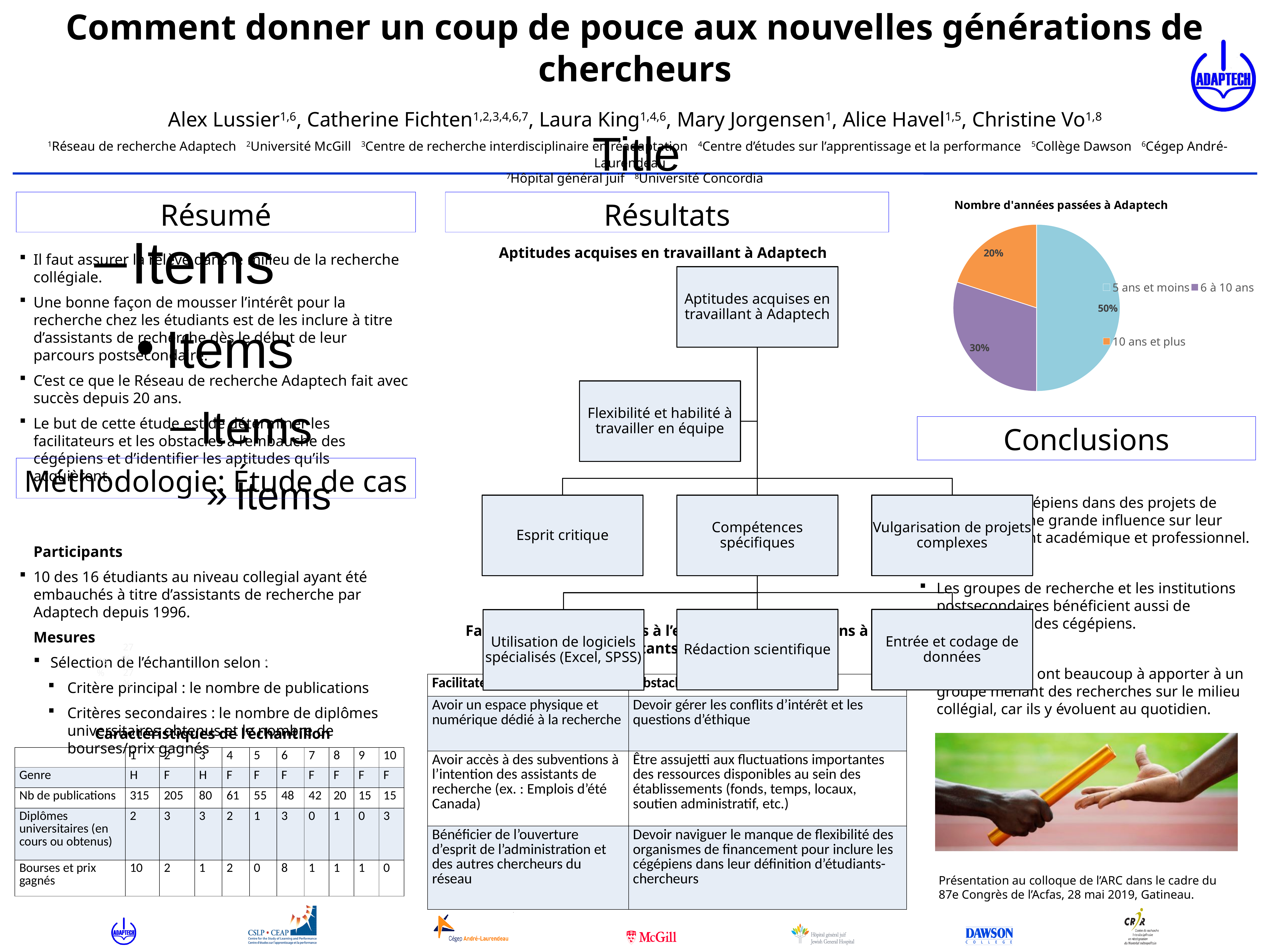
In the pie chart "Nombre d'années passées à Adaptech", which category has the smallest slice? 10 ans et plus How many slices does the pie chart "Nombre d'années passées à Adaptech" have? 3 In the pie chart "Nombre d'années passées à Adaptech", which category has the largest slice? 5 ans et moins In the pie chart "Nombre d'années passées à Adaptech", what share is shown for "10 ans et plus"? 20% In the pie chart "Nombre d'années passées à Adaptech", what is the difference in percentage points between "5 ans et moins" and "10 ans et plus"? 30 How many entries does the legend of the pie chart "Nombre d'années passées à Adaptech" list? 3 In the pie chart "Nombre d'années passées à Adaptech", what colour is the "10 ans et plus" slice? orange What is the title of the pie chart on the slide? Nombre d'années passées à Adaptech In the pie chart "Nombre d'années passées à Adaptech", what share is shown for "6 à 10 ans"? 30% In the pie chart "Nombre d'années passées à Adaptech", which is larger: "6 à 10 ans" or "10 ans et plus"? 6 à 10 ans In the pie chart "Nombre d'années passées à Adaptech", what share is shown for "5 ans et moins"? 50% What kind of chart is "Nombre d'années passées à Adaptech"? pie chart